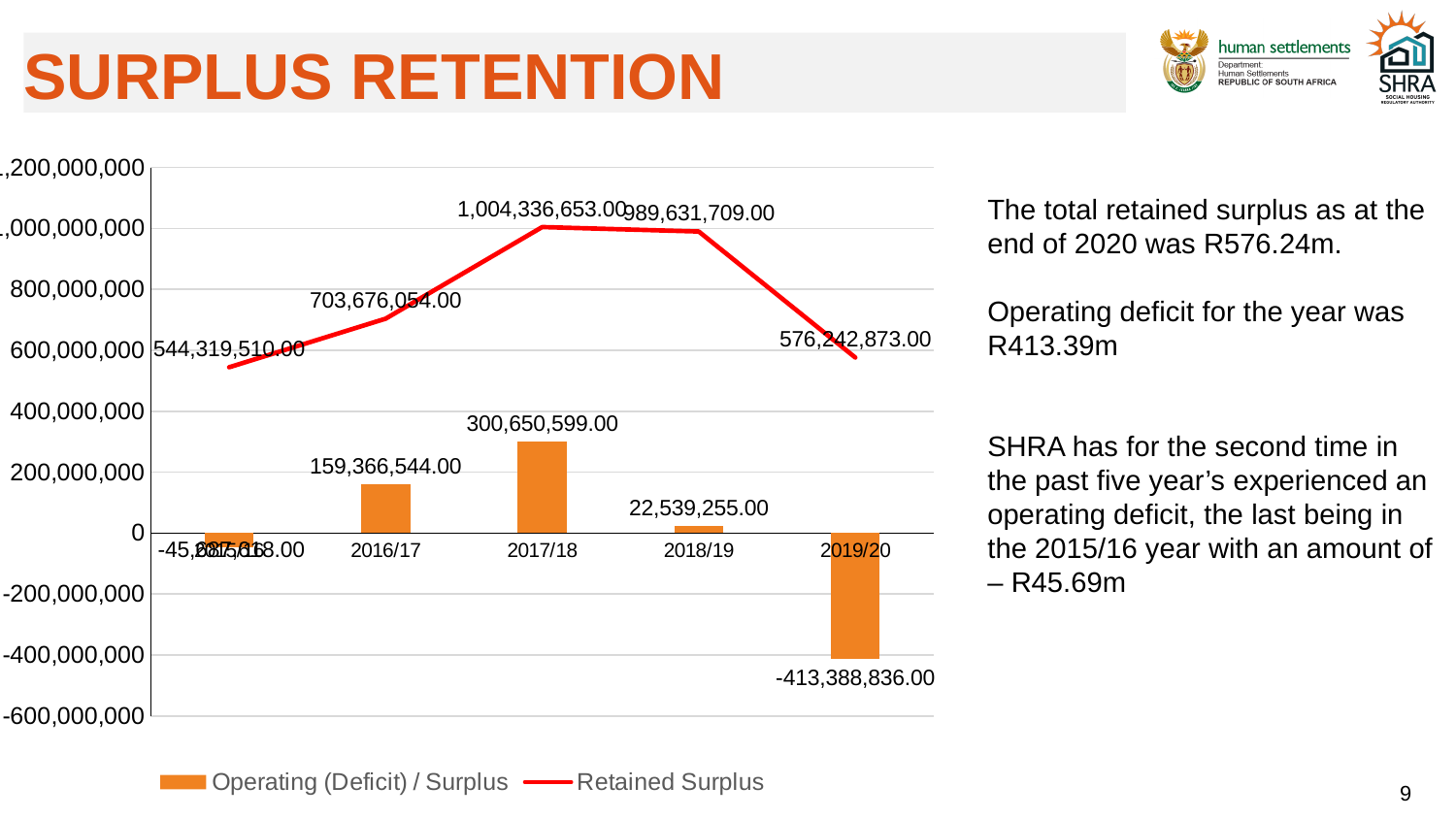
In which year is the Retained Surplus highest? 2017/18 In which year is the Operating (Deficit) / Surplus lowest? 2019/20 What is the Retained Surplus value for 2016/17? 703,676,054.00 What is the difference between the Retained Surplus in 2017/18 and 2018/19? 14,704,944.00 Which is larger, the Operating (Deficit) / Surplus in 2016/17 or in 2017/18? 2017/18 Does the Retained Surplus rise or fall from 2018/19 to 2019/20? fall What is the Operating (Deficit) / Surplus value for 2019/20? -413,388,836.00 What is the Retained Surplus value for 2017/18? 1,004,336,653.00 How many years are shown on the x axis of the chart? 5 What is the Operating (Deficit) / Surplus value for 2018/19? 22,539,255.00 Is the Retained Surplus for 2015/16 greater or less than 600,000,000? less How many series does the chart legend list? 2